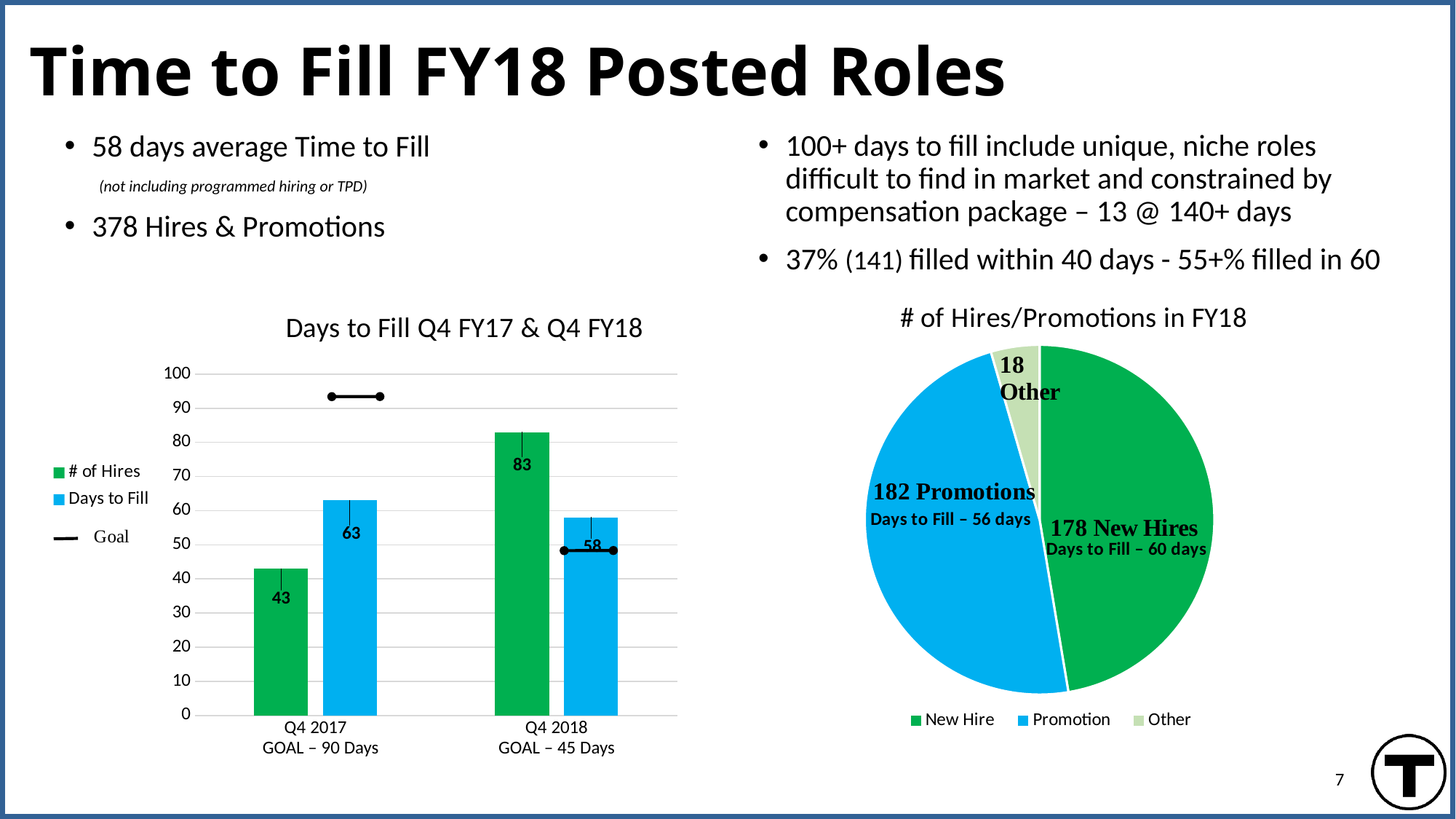
In the 'Days to Fill Q4 FY17 & Q4 FY18' chart, which quarter has the higher Days to Fill value, Q4 2017 or Q4 2018? Q4 2017 What kind of chart is 'Days to Fill Q4 FY17 & Q4 FY18'? bar chart In the '# of Hires/Promotions in FY18' pie chart, which category is the smallest? Other In the 'Days to Fill Q4 FY17 & Q4 FY18' chart, what is the Days to Fill value for Q4 2017? 63 In the 'Days to Fill Q4 FY17 & Q4 FY18' chart, how many series does the legend list? 3 In the '# of Hires/Promotions in FY18' pie chart, how many Promotions are shown? 182 In the 'Days to Fill Q4 FY17 & Q4 FY18' chart, what is the Days to Fill value for Q4 2018? 58 In the 'Days to Fill Q4 FY17 & Q4 FY18' chart, by how much did # of Hires increase from Q4 2017 to Q4 2018? 40 In the 'Days to Fill Q4 FY17 & Q4 FY18' chart, what is the # of Hires value for Q4 2017? 43 In the 'Days to Fill Q4 FY17 & Q4 FY18' chart, what is the goal in days for Q4 2018? 45 Days In the '# of Hires/Promotions in FY18' pie chart, what is the total of New Hires, Promotions and Other? 378 In the '# of Hires/Promotions in FY18' pie chart, how many slices are there? 3